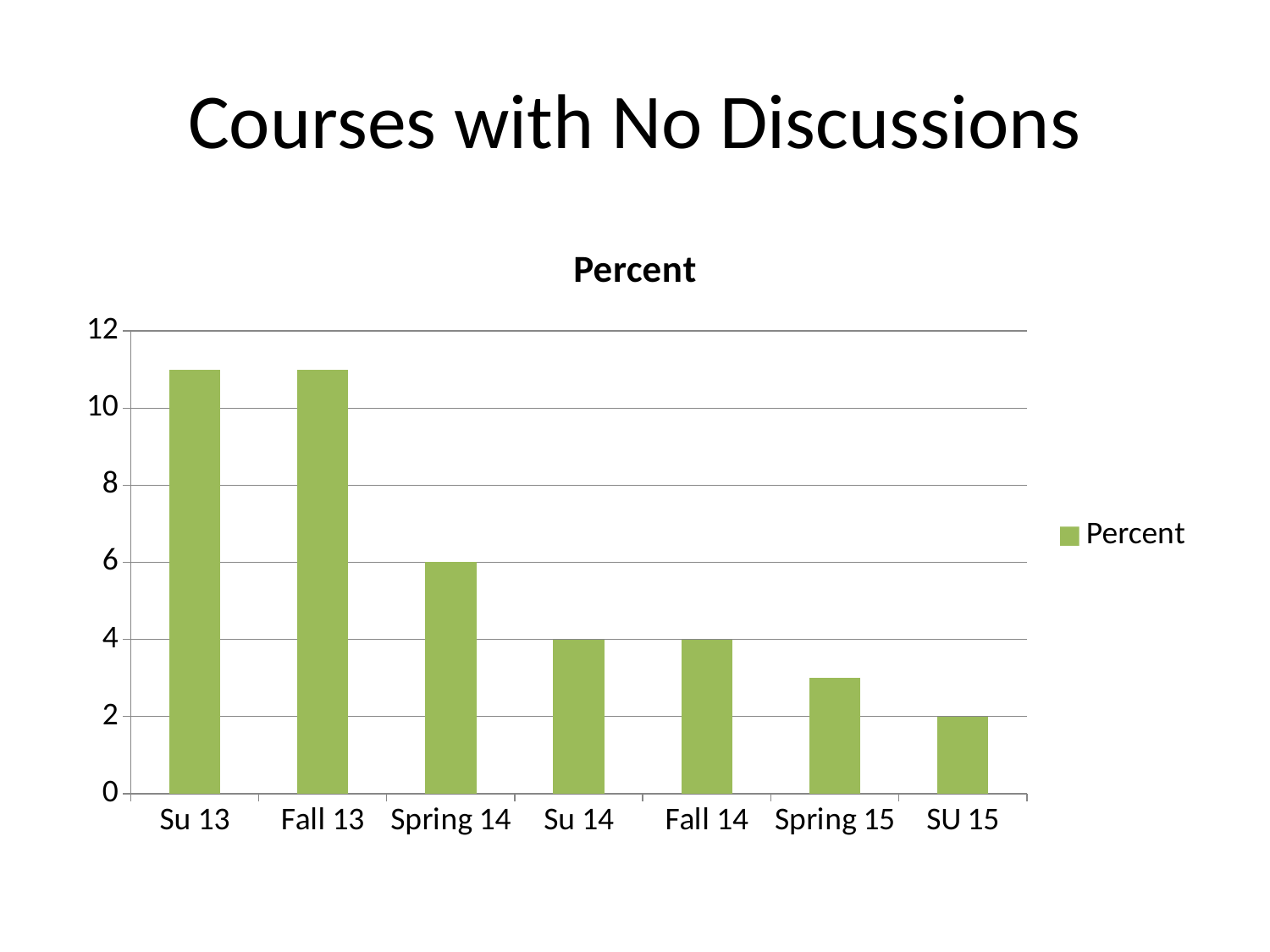
Which term has the lowest value? SU 15 What type of chart is shown on the slide? Bar chart How many series does the chart's legend list? 1 What is the value for Su 14? 4 How many categories (terms) are shown on the x axis of the chart? 7 Is the value for Spring 15 greater or less than 4? less What is the value for SU 15? 2 What is the difference between the values for Spring 14 and SU 15? 4 Is the value for Su 13 greater or less than 10? greater Which is larger, the value for Fall 13 or the value for Fall 14? Fall 13 What is the value for Spring 14? 6 Do the values generally rise or fall from Su 13 to SU 15? Fall